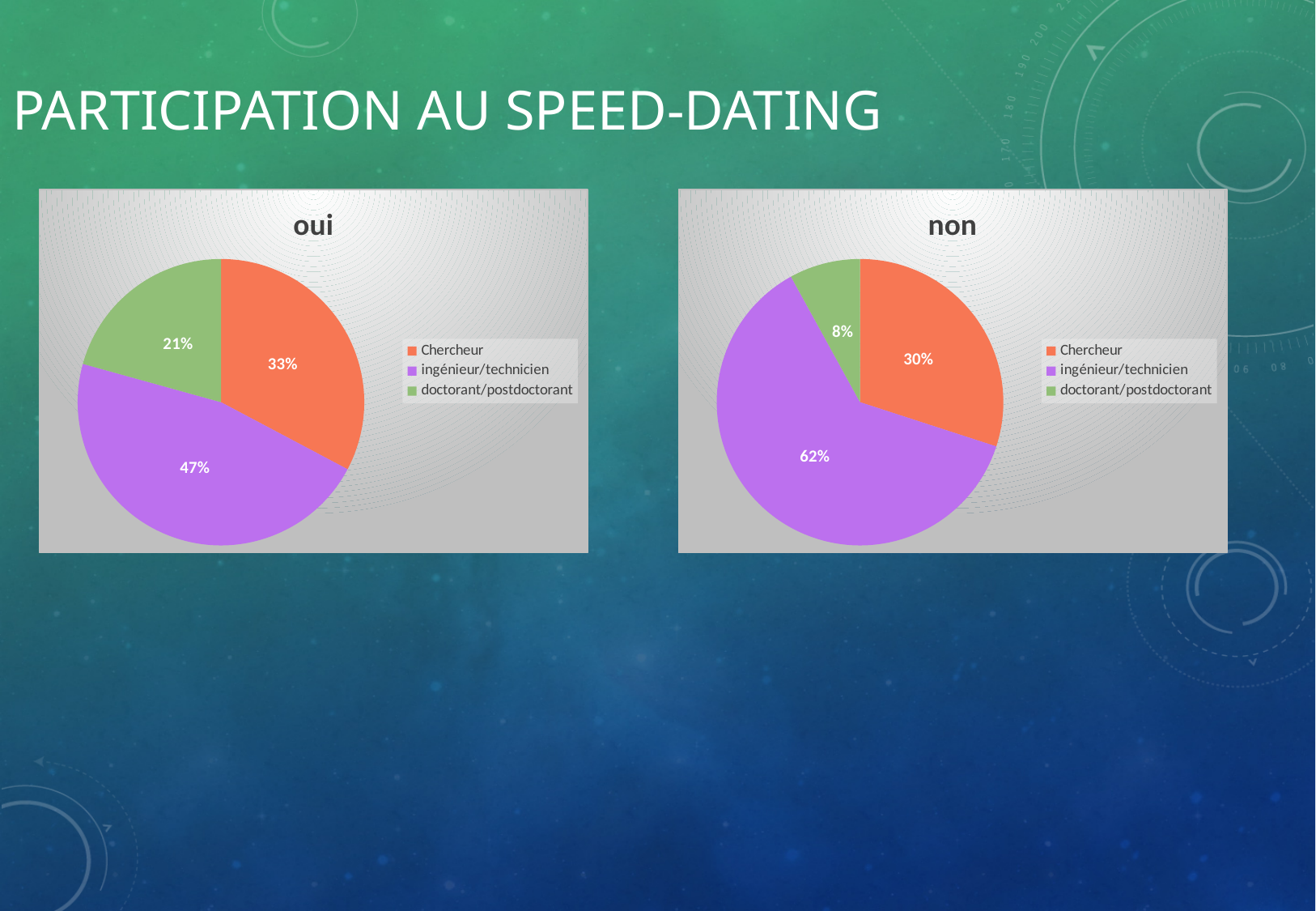
In the "oui" chart, which category has the smallest slice? doctorant/postdoctorant How many categories does the legend of the "oui" chart list? 3 In the "non" chart, what is the difference between the ingénieur/technicien share and the Chercheur share? 32% In the "oui" chart, which is larger, the Chercheur slice or the doctorant/postdoctorant slice? Chercheur In the "oui" chart, what share of the pie is Chercheur? 33% In the "non" chart, which category has the largest slice? ingénieur/technicien In the "oui" chart, what share of the pie is doctorant/postdoctorant? 21% In the "non" chart, what share of the pie is doctorant/postdoctorant? 8% What kind of chart is the "non" chart? Pie chart What colour is the ingénieur/technicien slice in the "non" chart? Purple